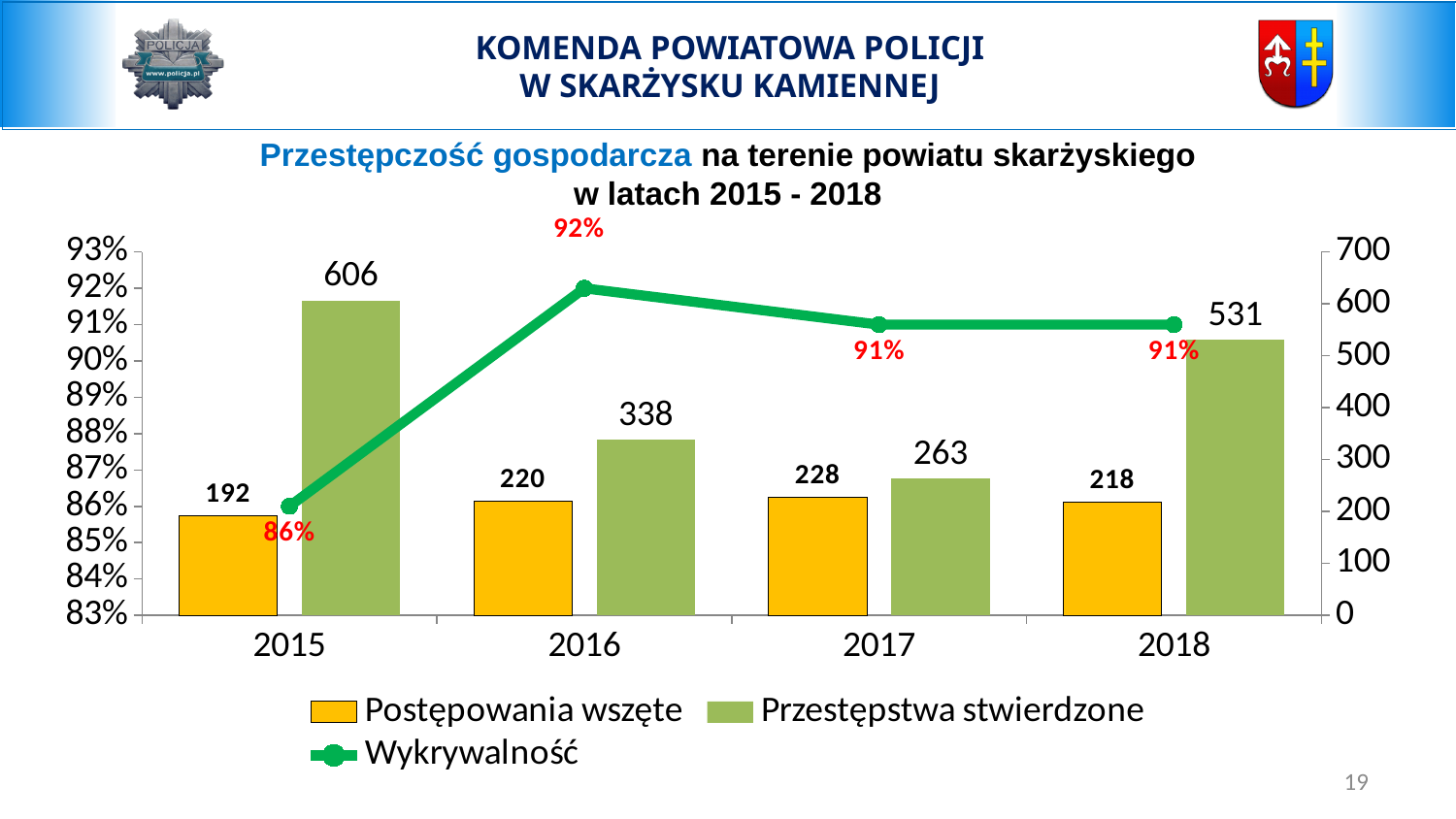
What is the value of Przestępstwa stwierdzone in 2015? 606 What is the value of Postępowania wszczęte in 2017? 228 How many series does the legend list? 3 In which year is Wykrywalność the lowest? 2015 Does Przestępstwa stwierdzone rise or fall from 2015 to 2017? fall Which series is drawn as a line rather than bars? Wykrywalność In which year is Przestępstwa stwierdzone the lowest? 2017 Which is larger: Przestępstwa stwierdzone in 2018 or in 2016? 2018 What is the Wykrywalność value for 2016? 92% What is the difference between Przestępstwa stwierdzone in 2015 and in 2016? 268 How many years are shown on the x axis? 4 In which year is Postępowania wszczęte the highest? 2017